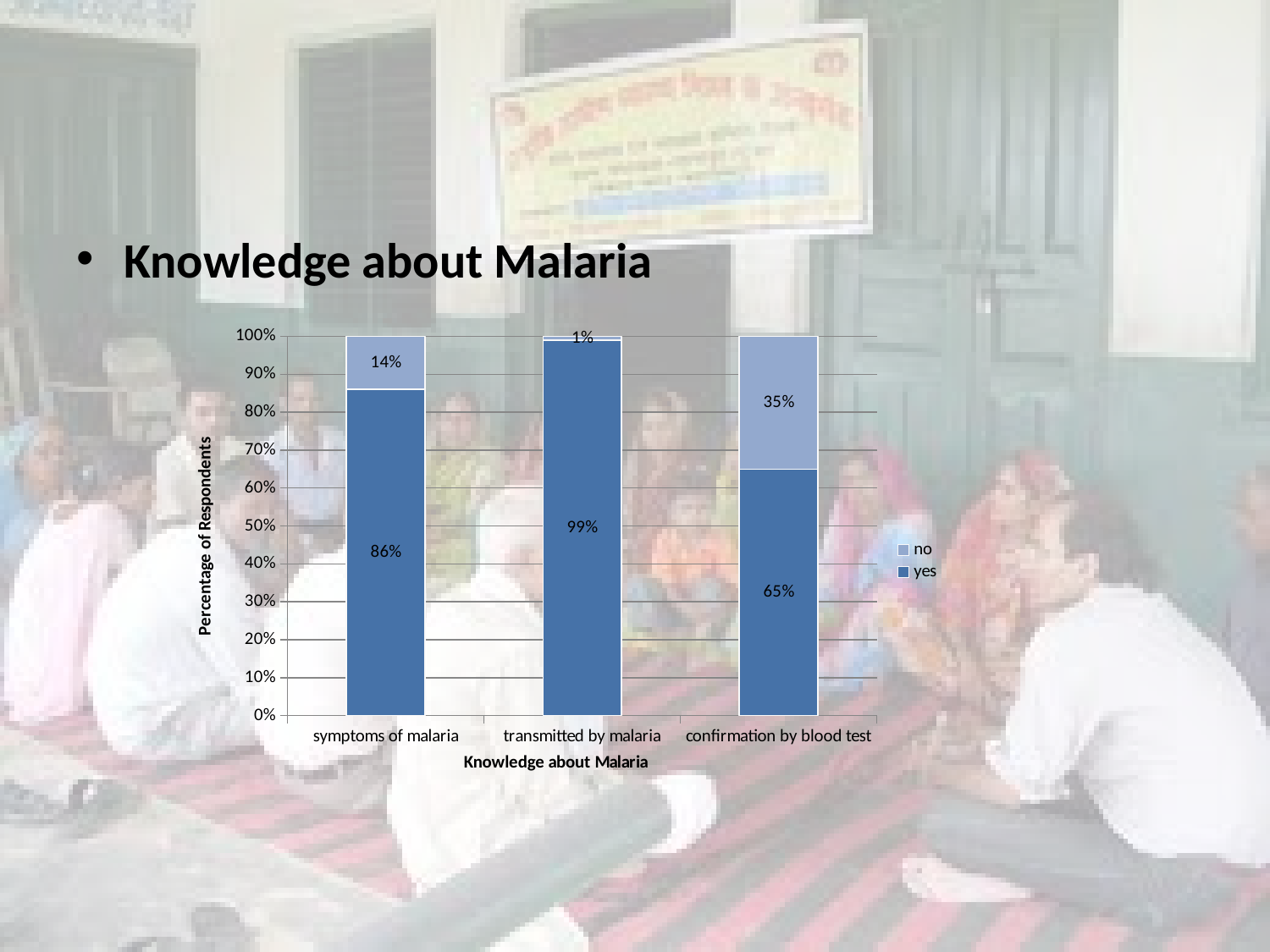
What percentage of respondents answered "yes" for transmitted by malaria? 99% What percentage of respondents answered "yes" for symptoms of malaria? 86% Which category has the highest "yes" percentage? transmitted by malaria What is the label of the y axis? Percentage of Respondents What percentage of respondents answered "no" for symptoms of malaria? 14% How many series does the legend list? 2 How many categories are shown on the x axis? 3 Is the "no" percentage larger for symptoms of malaria or for confirmation by blood test? confirmation by blood test What is the difference between the "yes" percentages for symptoms of malaria and confirmation by blood test? 21% Which category has the lowest "yes" percentage? confirmation by blood test What kind of chart is shown on the slide? stacked bar chart What percentage of respondents answered "no" for confirmation by blood test? 35%